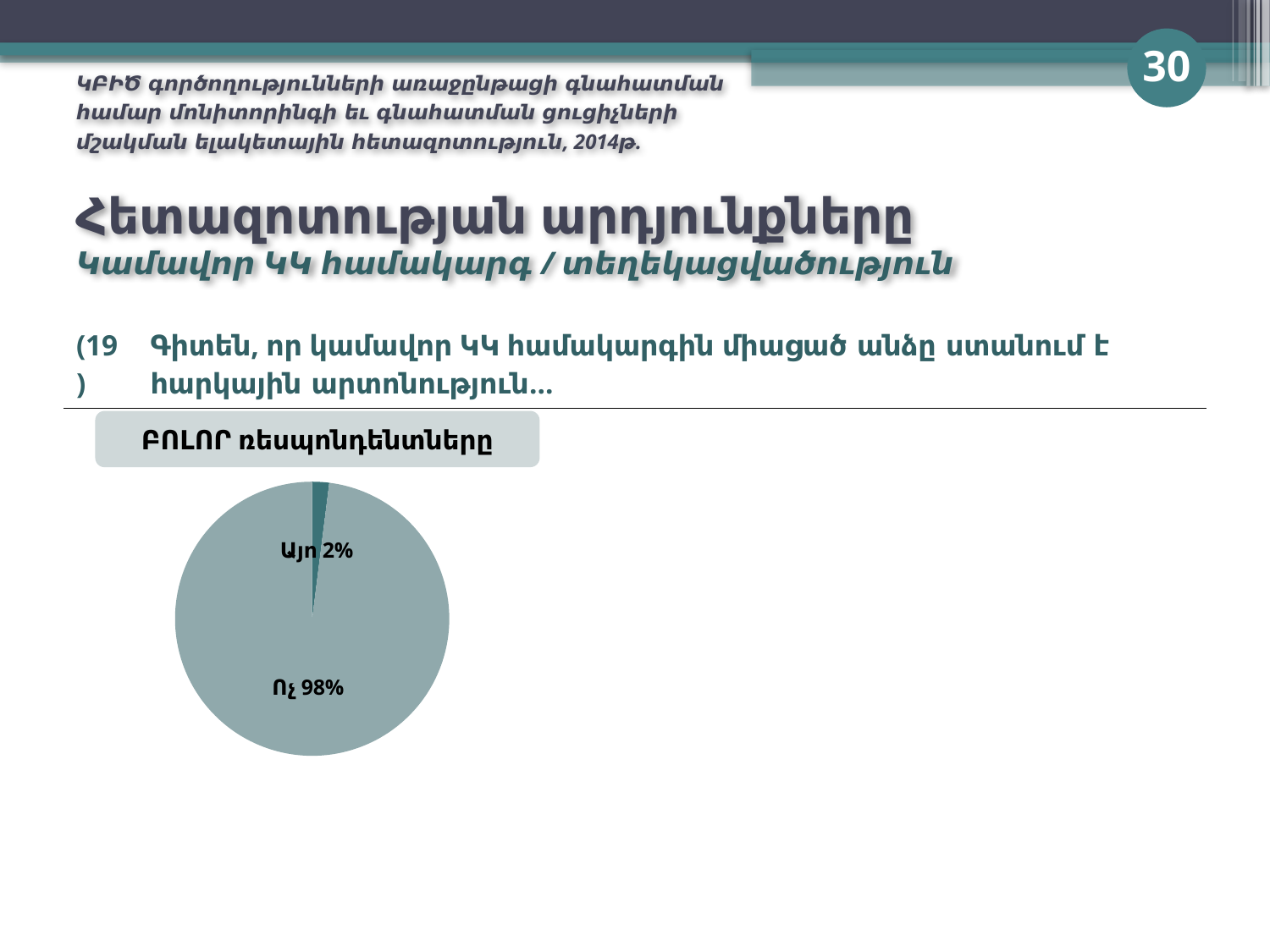
Which slice of the pie is the smallest? Այո What kind of chart is shown on the slide? pie chart Which slice of the pie is the largest? Ոչ Is the share for "Ոչ" greater or less than 50%? greater What share of the pie is labelled "Այո"? 2% What share of the pie is labelled "Ոչ"? 98% What is the difference in percentage points between the "Ոչ" slice and the "Այո" slice? 96 Which is larger, the "Այո" slice or the "Ոչ" slice? Ոչ How many slices does the pie chart have? 2 What is the combined share of the "Այո" and "Ոչ" slices? 100% What is the heading shown directly above the pie chart? ԲՈԼՈՐ ռեսպոնդենտները